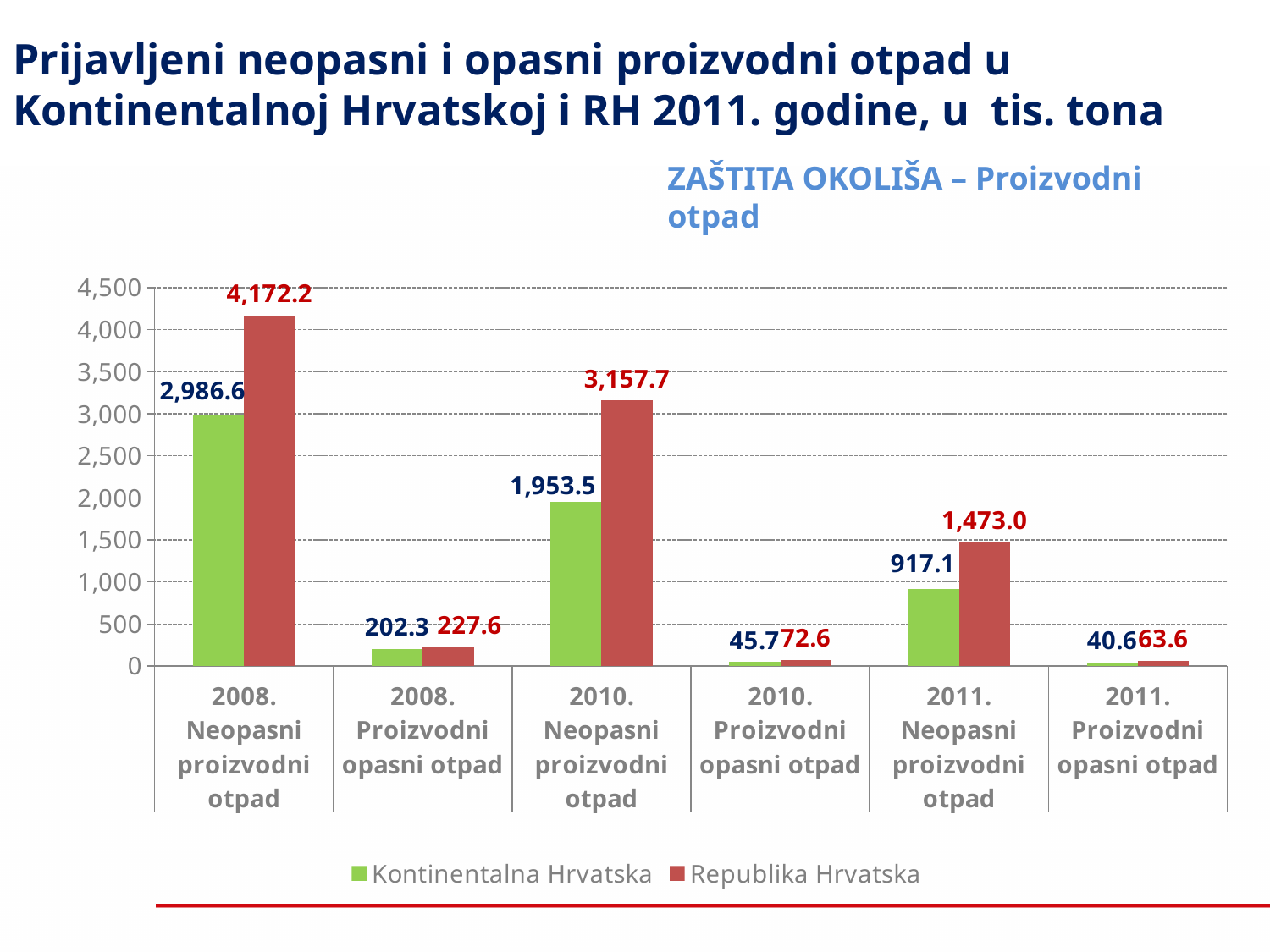
Which is larger: the Kontinentalna Hrvatska value for 2010. Neopasni proizvodni otpad or the Republika Hrvatska value for 2011. Neopasni proizvodni otpad? Kontinentalna Hrvatska value for 2010. Neopasni proizvodni otpad What is the value for Republika Hrvatska in the category 2010. Neopasni proizvodni otpad? 3,157.7 What is the value for Kontinentalna Hrvatska in the category 2010. Proizvodni opasni otpad? 45.7 What is the difference between the Republika Hrvatska and Kontinentalna Hrvatska values for 2008. Neopasni proizvodni otpad? 1,185.6 What is the value for Kontinentalna Hrvatska in the category 2008. Neopasni proizvodni otpad? 2,986.6 How many series does the legend list? 2 What is the difference between the Republika Hrvatska and Kontinentalna Hrvatska values for 2011. Neopasni proizvodni otpad? 555.9 How many categories are shown on the x axis? 6 What is the value for Republika Hrvatska in the category 2011. Proizvodni opasni otpad? 63.6 Which category has the highest value for Republika Hrvatska? 2008. Neopasni proizvodni otpad What kind of chart is shown on the slide? Bar chart Which category has the lowest value for Kontinentalna Hrvatska? 2011. Proizvodni opasni otpad